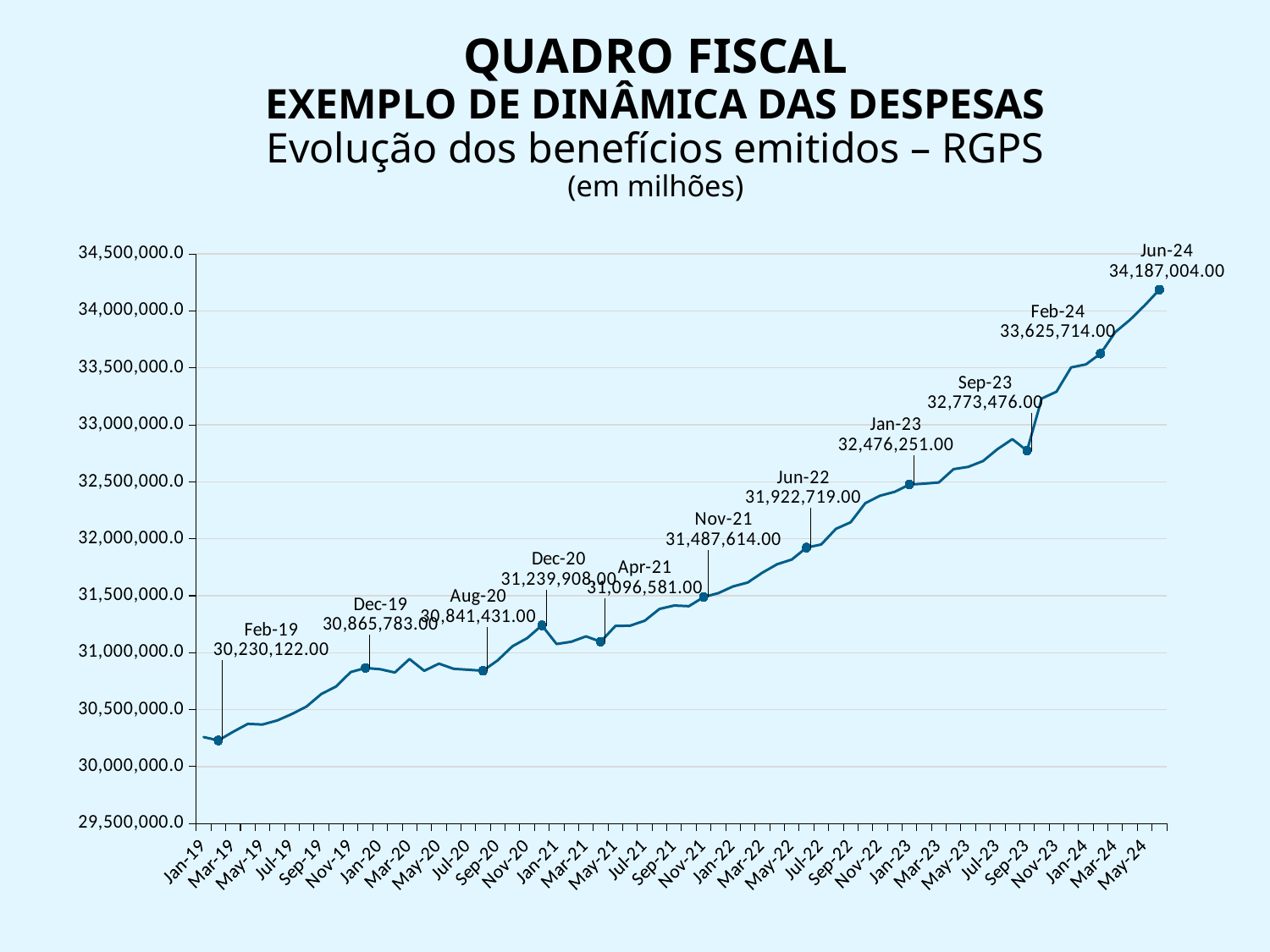
What kind of chart is shown on the slide? line chart What value is labelled for Aug-20 on the chart? 30,841,431.00 What value is labelled for Jun-24 on the chart? 34,187,004.00 How many data points on the chart have printed value labels? 11 Which labelled value is larger, Dec-20 or Apr-21? Dec-20 Is the value for Jan-19 greater or less than 30,500,000.0? less What is the difference between the labelled values for Feb-24 and Jan-23? 1,149,463.00 Which labelled point on the chart has the highest value? Jun-24 What value is labelled for Jan-23 on the chart? 32,476,251.00 What is the difference between the labelled values for Jun-24 and Feb-19? 3,956,882.00 What value is labelled for Feb-19 on the chart? 30,230,122.00 Which labelled point on the chart has the lowest value? Feb-19